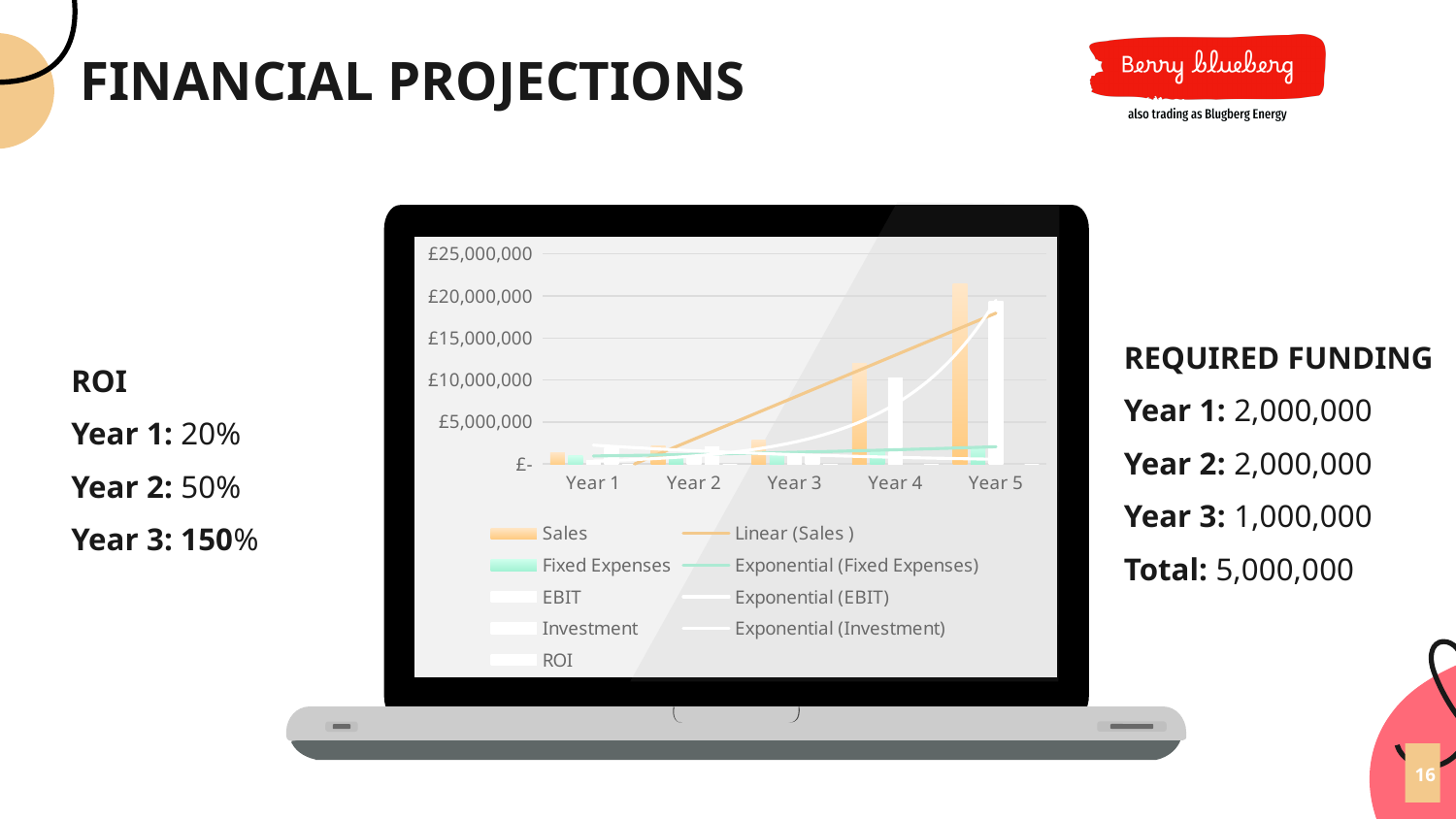
How many year categories are shown on the x axis of the chart? 5 Is the Sales value for Year 3 greater or less than £5,000,000? less What is the highest value labelled on the chart's vertical axis? £25,000,000 Is the Sales value for Year 4 greater or less than £10,000,000? greater Is the Sales value for Year 5 greater or less than £20,000,000? greater Do the Sales values rise or fall from Year 1 to Year 5? rise How many entries does the chart's legend list? 9 What is the legend label for the trendline of the Sales series? Linear (Sales ) What kind of chart is shown on the laptop screen? bar chart In Year 4, which is larger, Sales or Fixed Expenses? Sales In which year is the Sales bar highest? Year 5 Which year has the larger Sales bar, Year 4 or Year 5? Year 5